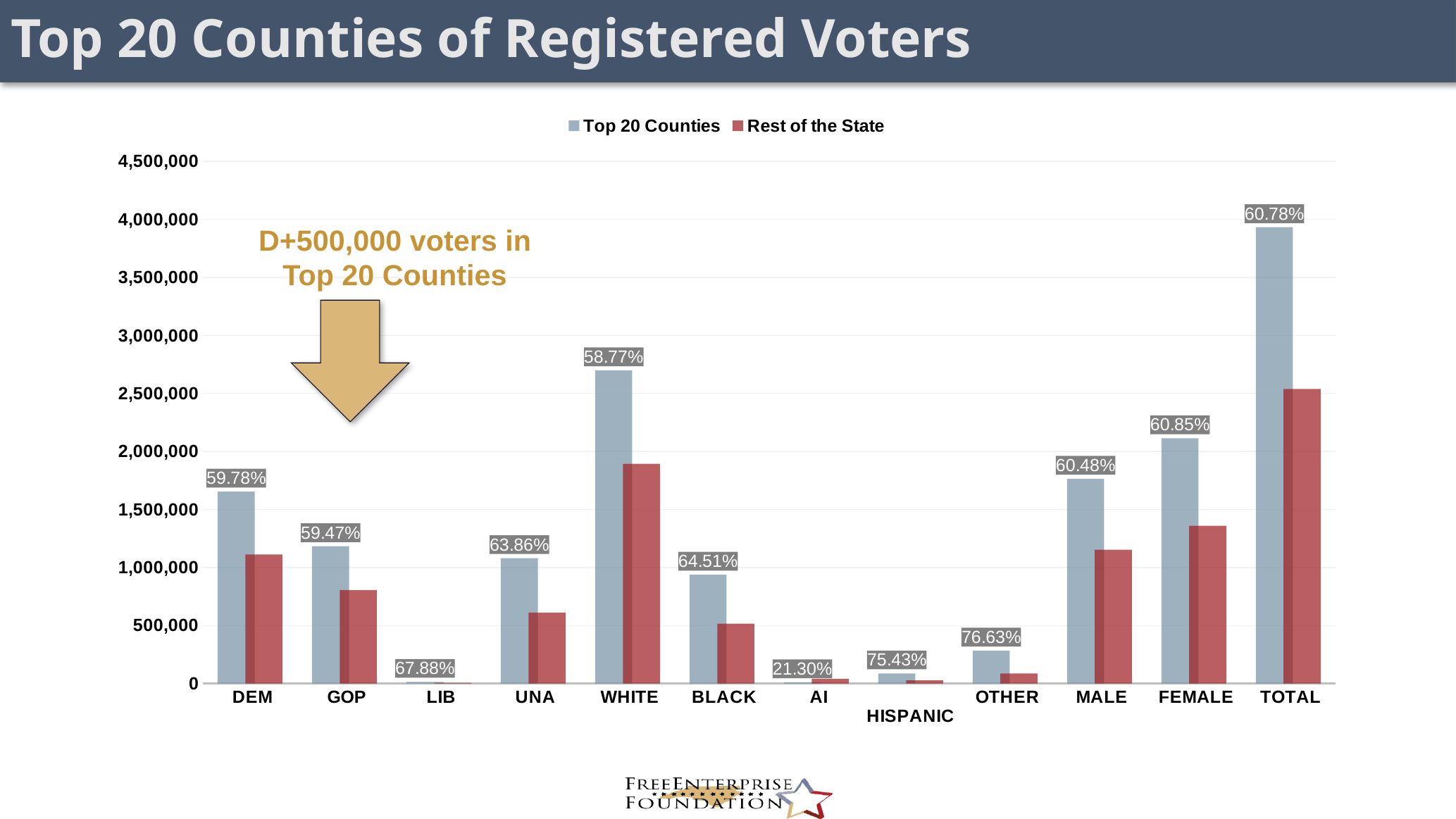
What percentage label is shown above the Top 20 Counties bar for TOTAL? 60.78% Which category has the highest percentage label? OTHER How many series does the legend list? 2 Which category has the lowest percentage label? AI Which is larger, the Top 20 Counties value for DEM or the Top 20 Counties value for GOP? DEM What percentage label is shown above the Top 20 Counties bar for DEM? 59.78% What kind of chart is shown on the slide? bar chart Which series is shown in red? Rest of the State Is the Top 20 Counties value for WHITE greater or less than 2,500,000? greater What is the difference between the percentage labels for FEMALE and MALE? 0.37% How many categories are shown along the x axis? 12 What percentage label is shown above the Top 20 Counties bar for OTHER? 76.63%